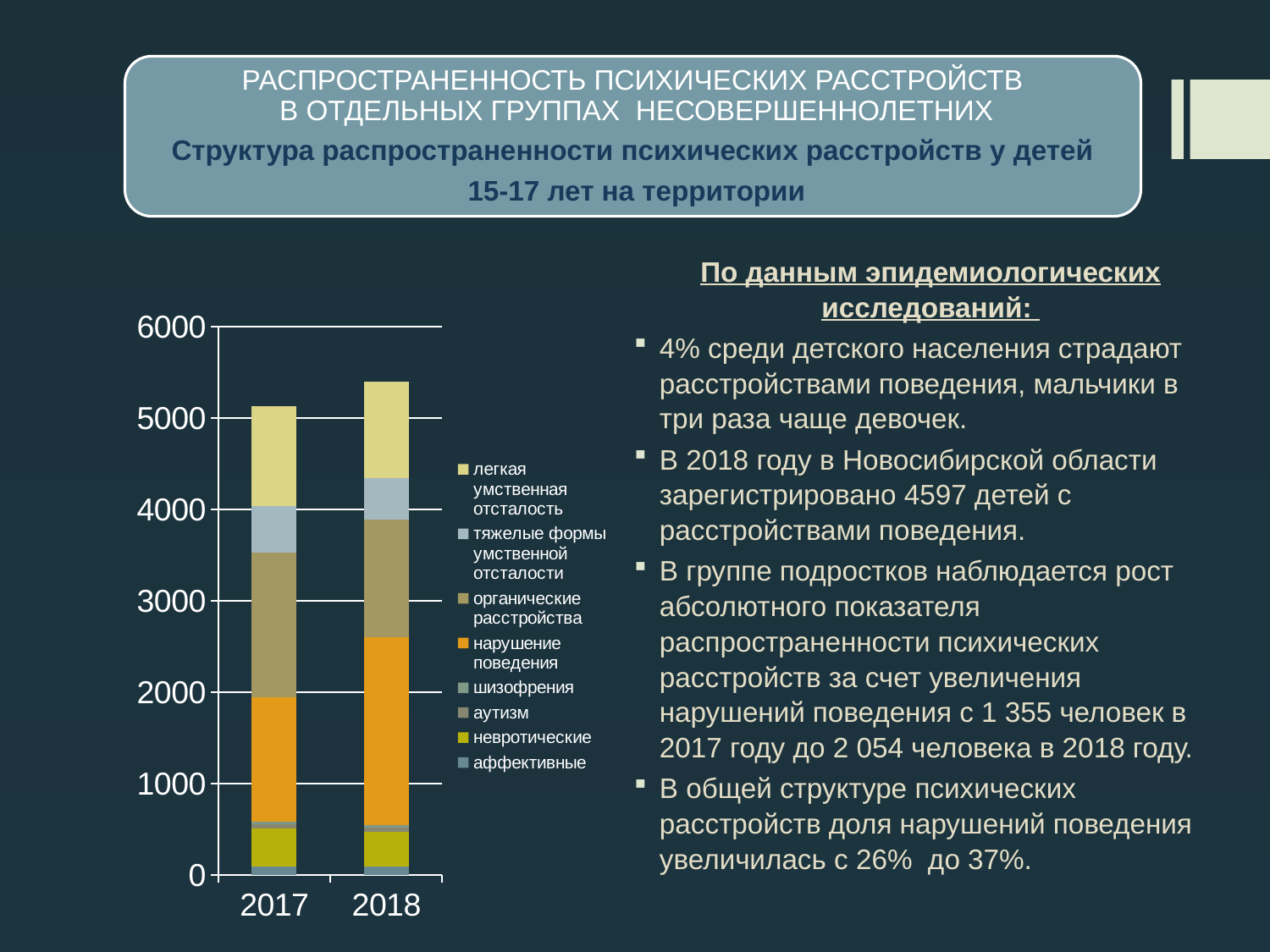
Does the total height of the stacked bars rise or fall from 2017 to 2018? rise How many categories (years) are shown on the x axis of the chart? 2 Is the total of the 2018 stacked bar greater or less than 6000? less What kind of chart is shown on the slide? stacked bar chart How many series does the chart legend list? 8 Which year has the taller stacked bar, 2017 or 2018? 2018 What is the highest value shown on the y axis of the chart? 6000 What is the first series listed in the chart legend? легкая умственная отсталость Is the total of the 2018 stacked bar greater or less than 5000? greater What colour represents the series 'нарушение поведения' in the chart? orange Is the total of the 2017 stacked bar greater or less than 6000? less Which series is the largest segment in the 2018 bar? нарушение поведения